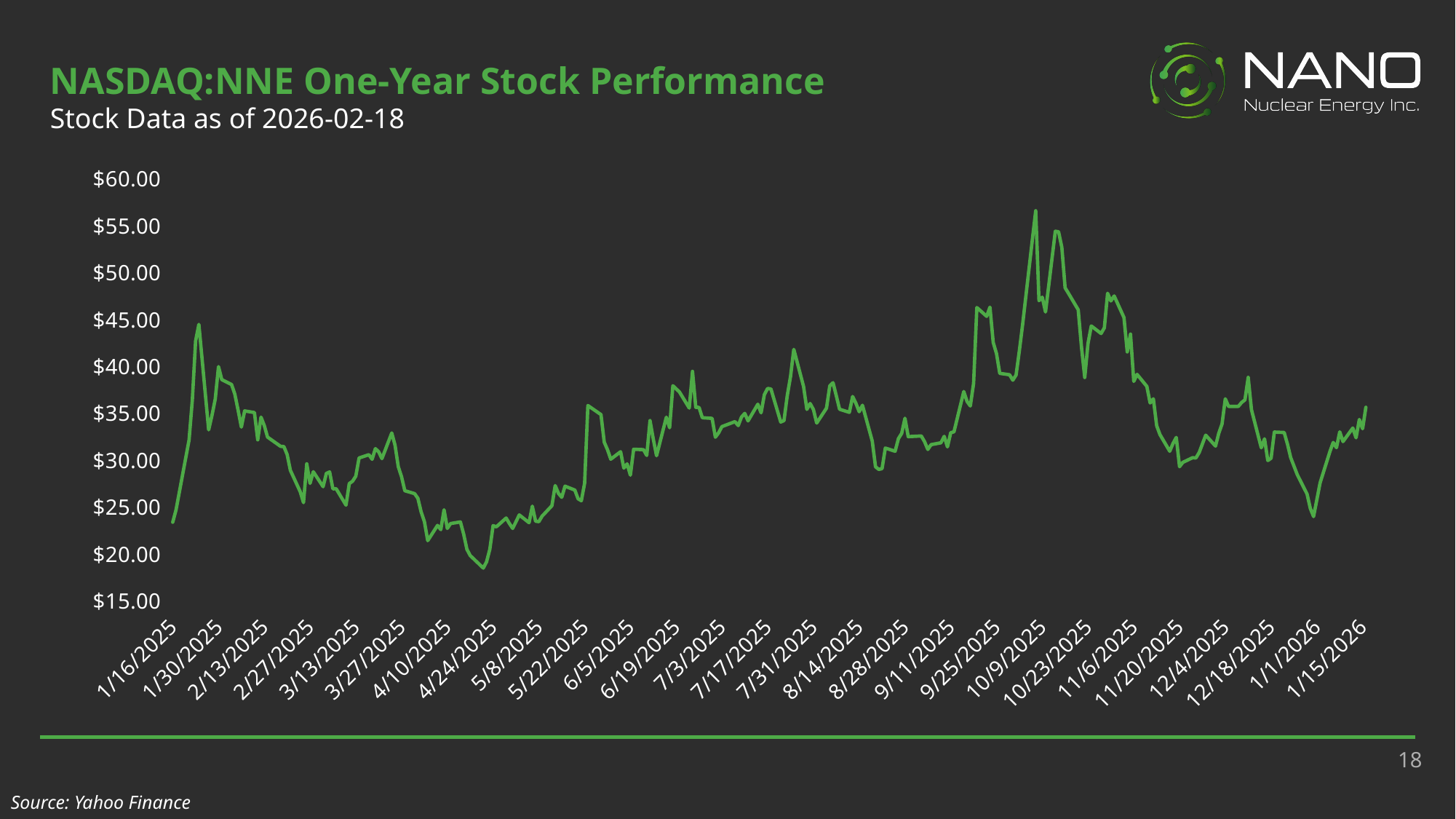
What source is cited for the stock data on the slide? Yahoo Finance How many date labels are shown along the x axis? 27 Is the stock price at the end of the chart, 1/15/2026, greater or less than $30.00? greater What kind of chart is shown on the slide? line chart Is the highest peak of the stock price, near 10/9/2025, greater or less than $55.00? greater What is the lowest value shown on the y axis? $15.00 Is the lowest point of the stock price, near 4/24/2025, greater or less than $20.00? less Around which x-axis date does the stock price reach its highest peak? 10/9/2025 Does the stock price rise or fall between 1/16/2025 and 1/30/2025? rise What is the highest value shown on the y axis? $60.00 What is the title of the chart on the slide? NASDAQ:NNE One-Year Stock Performance